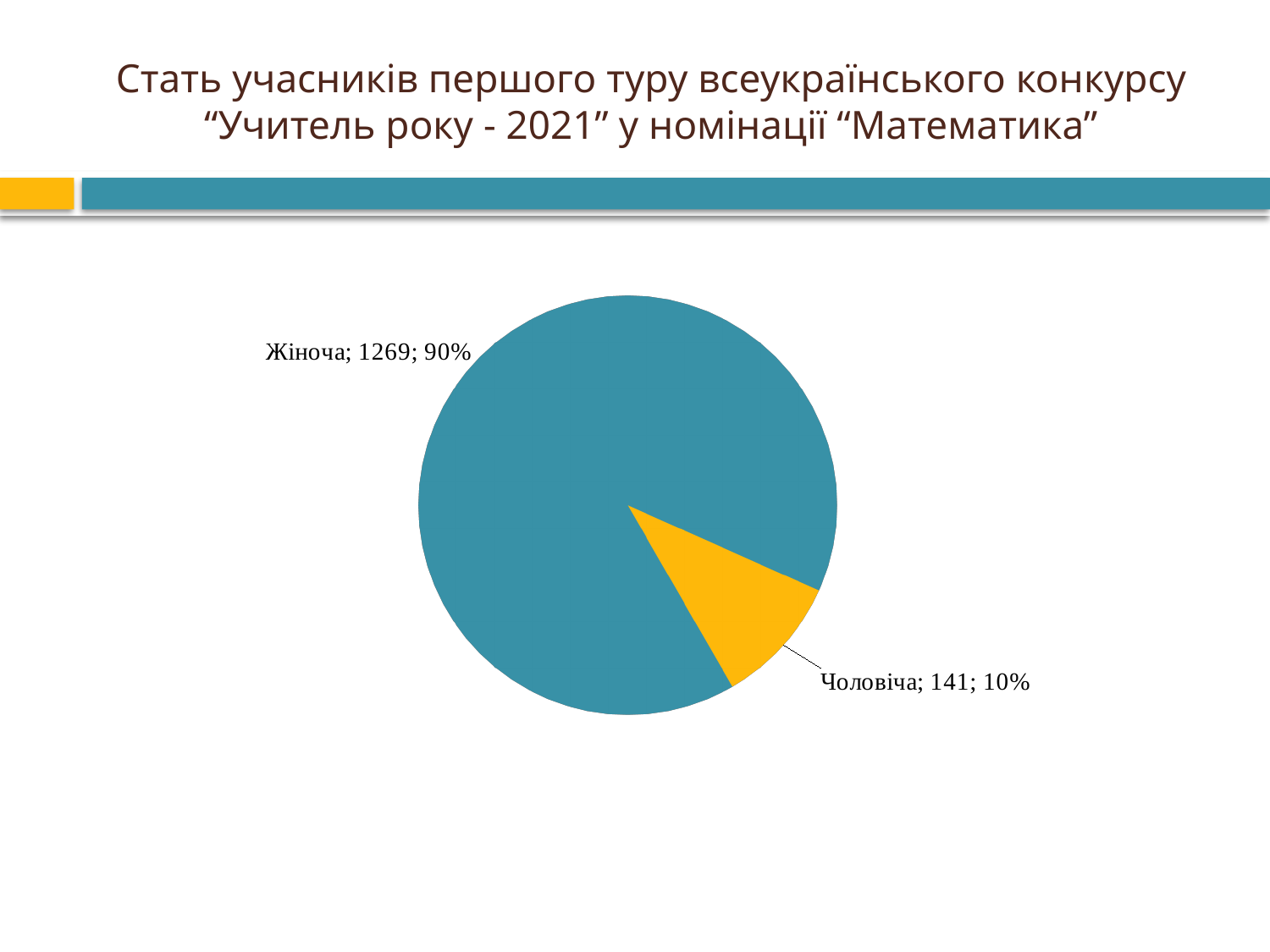
Which is larger, the value for Жіноча or the value for Чоловіча? Жіноча What is the value for Жіноча? 1269 What is the total of the two slices in the pie chart? 1410 What is the value for Чоловіча? 141 What kind of chart is shown on the slide? pie chart What colour is the Чоловіча slice? yellow How many slices does the pie chart have? 2 What share of the pie does the Жіноча slice represent? 90% Which category has the smallest slice? Чоловіча Which category has the largest slice? Жіноча What share of the pie does the Чоловіча slice represent? 10% What is the difference between the values for Жіноча and Чоловіча? 1128